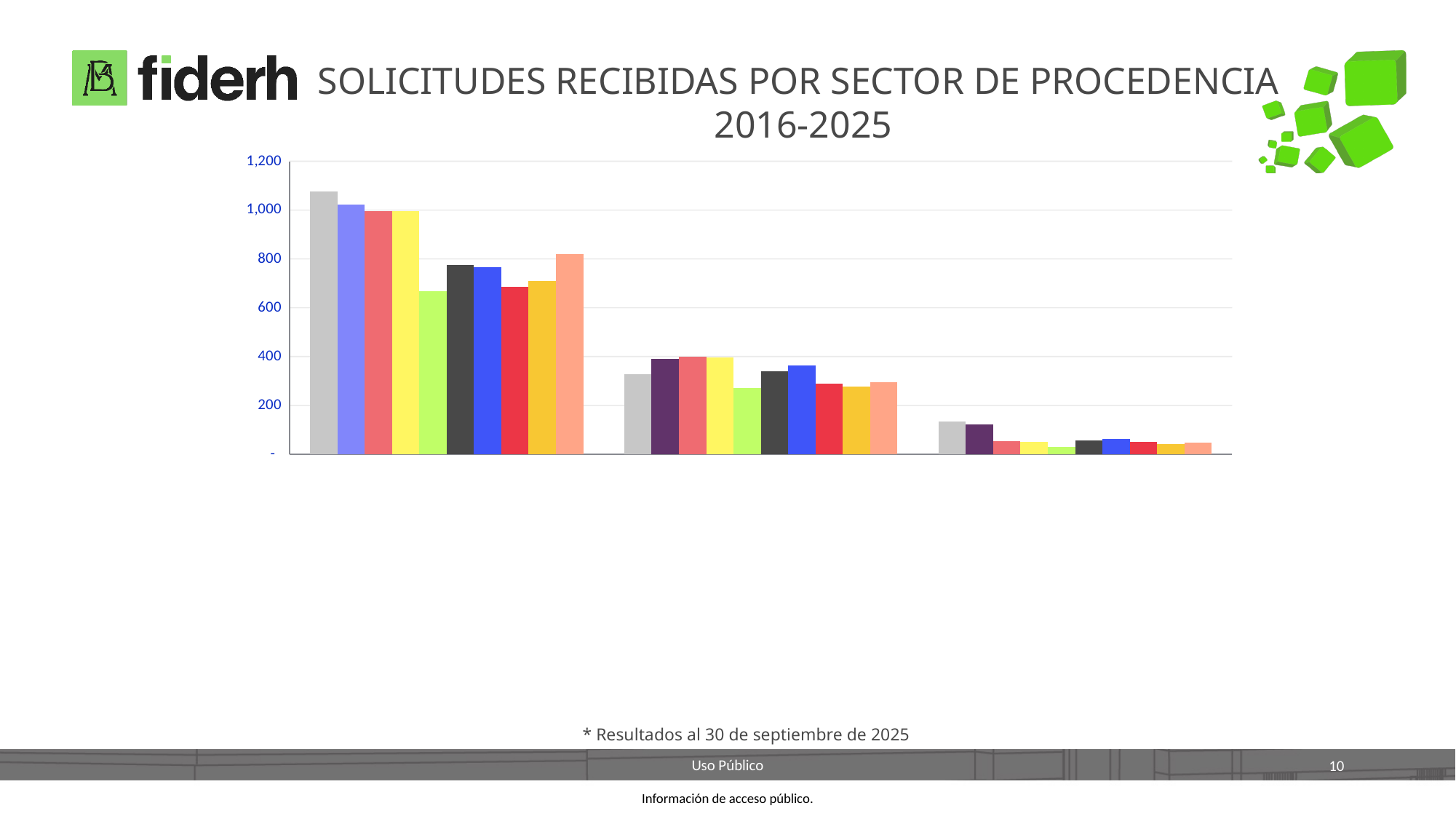
Is the value of the light green bar in the leftmost group greater or less than 800? less Do the bar heights generally rise or fall moving from the leftmost group to the rightmost group? fall Is the value of the tallest bar in the middle group greater or less than 600? less Is the value of the tallest bar in the rightmost group greater or less than 200? less What kind of chart is shown on the slide? bar chart How many bars are there in each group of the chart? 10 Which group of bars has the highest values: the leftmost, middle, or rightmost? leftmost Which group of bars has the lowest values: the leftmost, middle, or rightmost? rightmost What is the highest value shown on the vertical axis of the chart? 1,200 What is the title of the chart on the slide? SOLICITUDES RECIBIDAS POR SECTOR DE PROCEDENCIA 2016-2025 How many groups of bars are plotted in the chart? 3